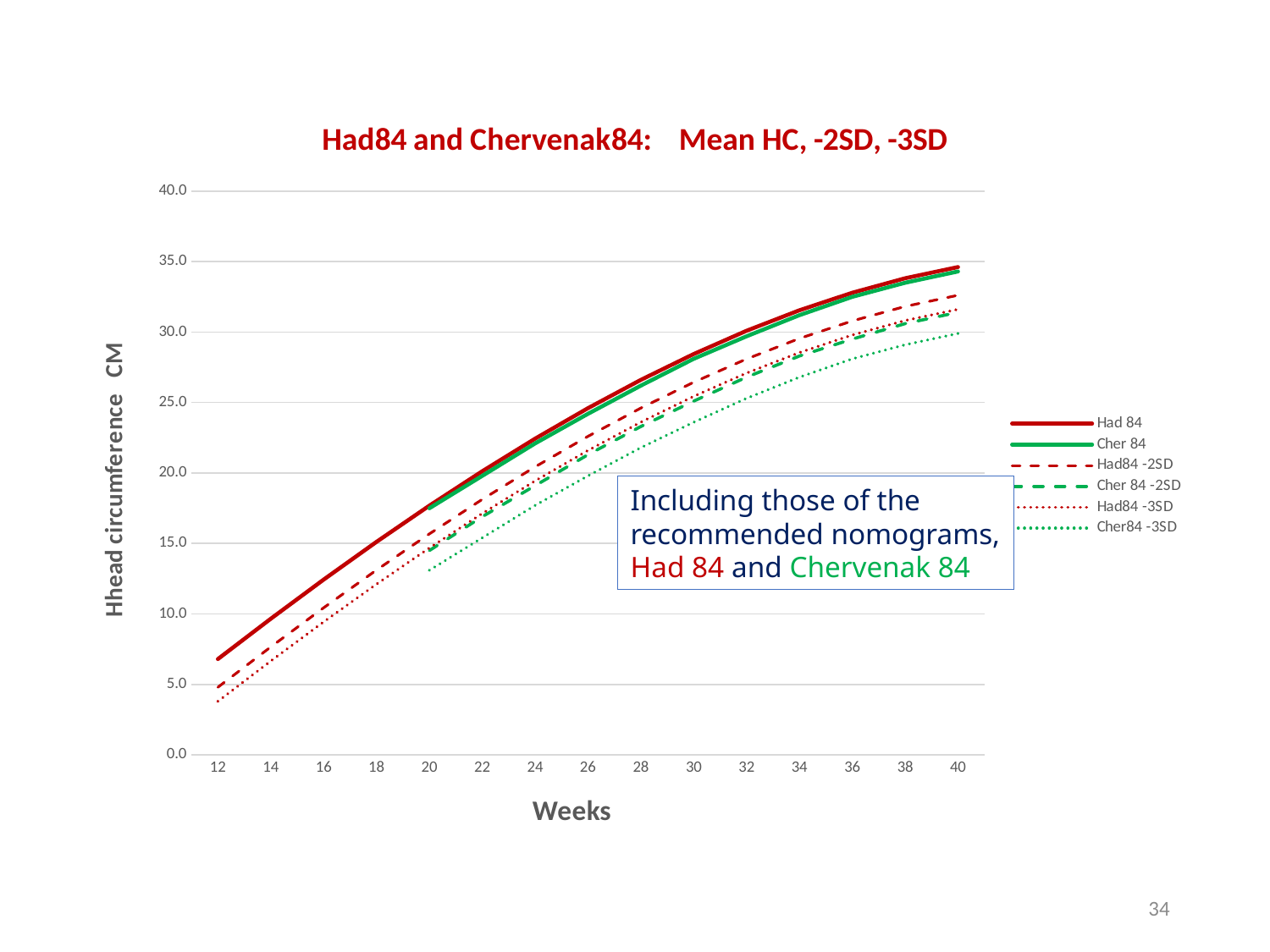
Is the value of Had 84 at week 40 greater or less than 30? greater Is the value of Had84 -2SD at week 40 greater or less than 30? greater What kind of chart is shown on the slide? line chart How many series does the legend list? 6 Do the values of the Had 84 series rise or fall as the weeks increase? rise Is the value of Had84 -3SD at week 12 greater or less than 5? less What is the title of the chart? Had84 and Chervenak84: Mean HC, -2SD, -3SD What is the label of the x axis? Weeks At week 40, which is larger: Had 84 or Cher84 -3SD? Had 84 Which series has the lowest value at week 40? Cher84 -3SD